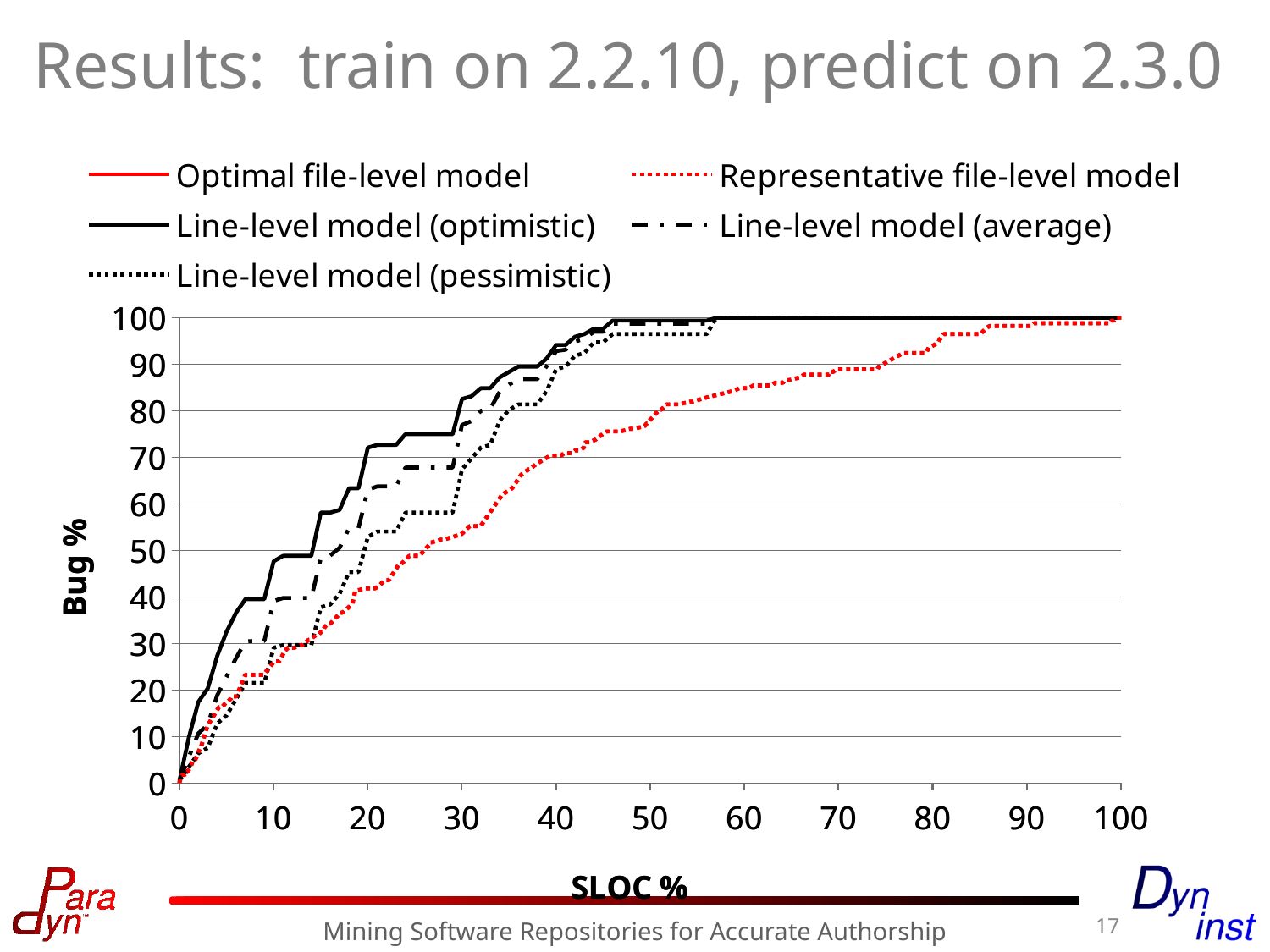
How many series does the legend list? 5 What kind of chart is shown on the slide? line chart Do the Bug % values rise or fall as SLOC % increases? rise Is the value of the Line-level model (average) at 10 SLOC % greater or less than 30? greater What is the label of the horizontal axis? SLOC % At 20 SLOC %, which is higher: the Line-level model (optimistic) or the Representative file-level model? Line-level model (optimistic) Is the value of the Line-level model (optimistic) at 20 SLOC % greater or less than 60? greater What is the label of the vertical axis? Bug % Which series is the last to reach 100 Bug % along the SLOC % axis? Representative file-level model Is the value of the Representative file-level model at 70 SLOC % greater or less than 80? greater Which series has the lowest Bug % at 60 SLOC %? Representative file-level model